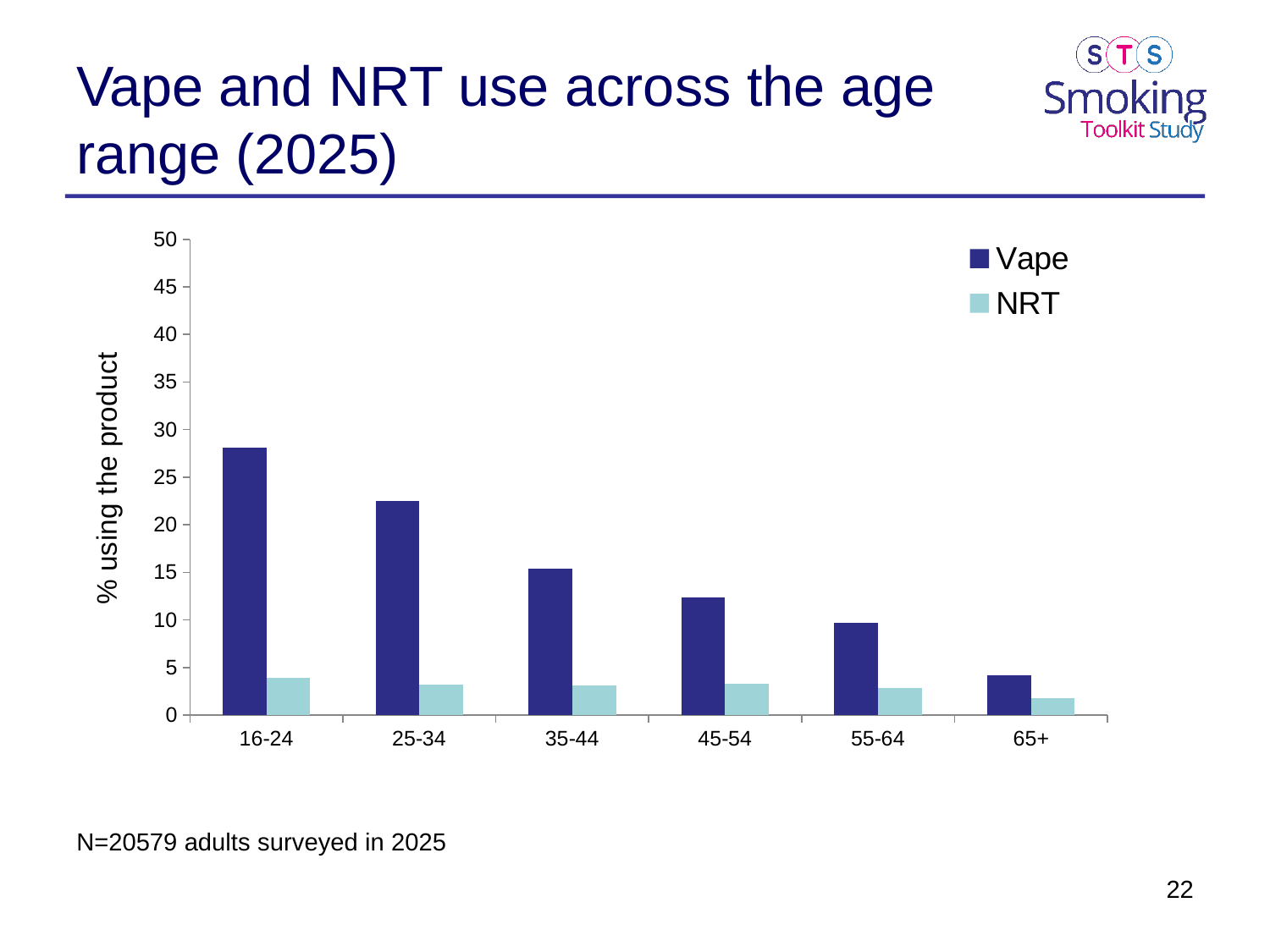
Do the Vape values rise or fall as age increases along the x axis? fall Which age group has the highest Vape value? 16-24 What kind of chart is shown on the slide? bar chart Is the Vape value for 65+ greater or less than 5? less Which age group has the lowest Vape value? 65+ How many series does the legend list? 2 Which age group has the lowest NRT value? 65+ Is the Vape value for 25-34 greater or less than 20? greater Is the NRT value for 16-24 greater or less than 5? less In the 16-24 age group, which is larger, Vape or NRT? Vape How many age groups are shown on the x axis? 6